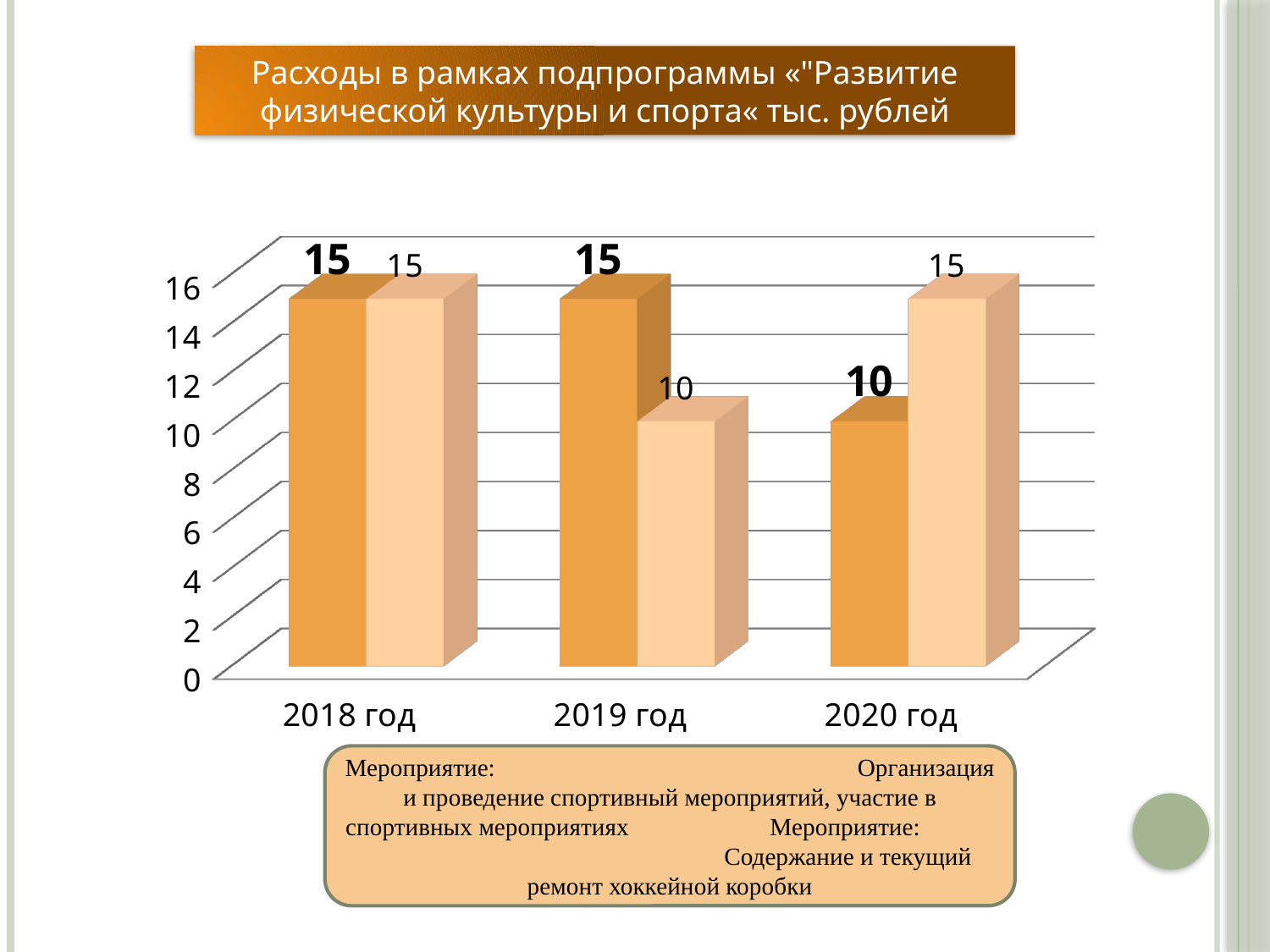
For 2020 год, which bar is larger, the darker orange bar or the lighter bar? the lighter bar How many year categories are shown on the x axis? 3 Is the value of the lighter bar for 2019 год greater or less than 12? less How many bars are shown for each year? 2 What is the difference between the darker orange bar and the lighter bar for 2019 год? 5 In which year is the darker orange bar lowest? 2020 год What is the value of the darker orange bar for 2018 год? 15 What is the total of the two bars for 2019 год? 25 What is the value of the lighter bar for 2020 год? 15 What kind of chart is shown on the slide? bar chart What is the value of the darker orange bar for 2020 год? 10 What is the value of the lighter bar for 2019 год? 10